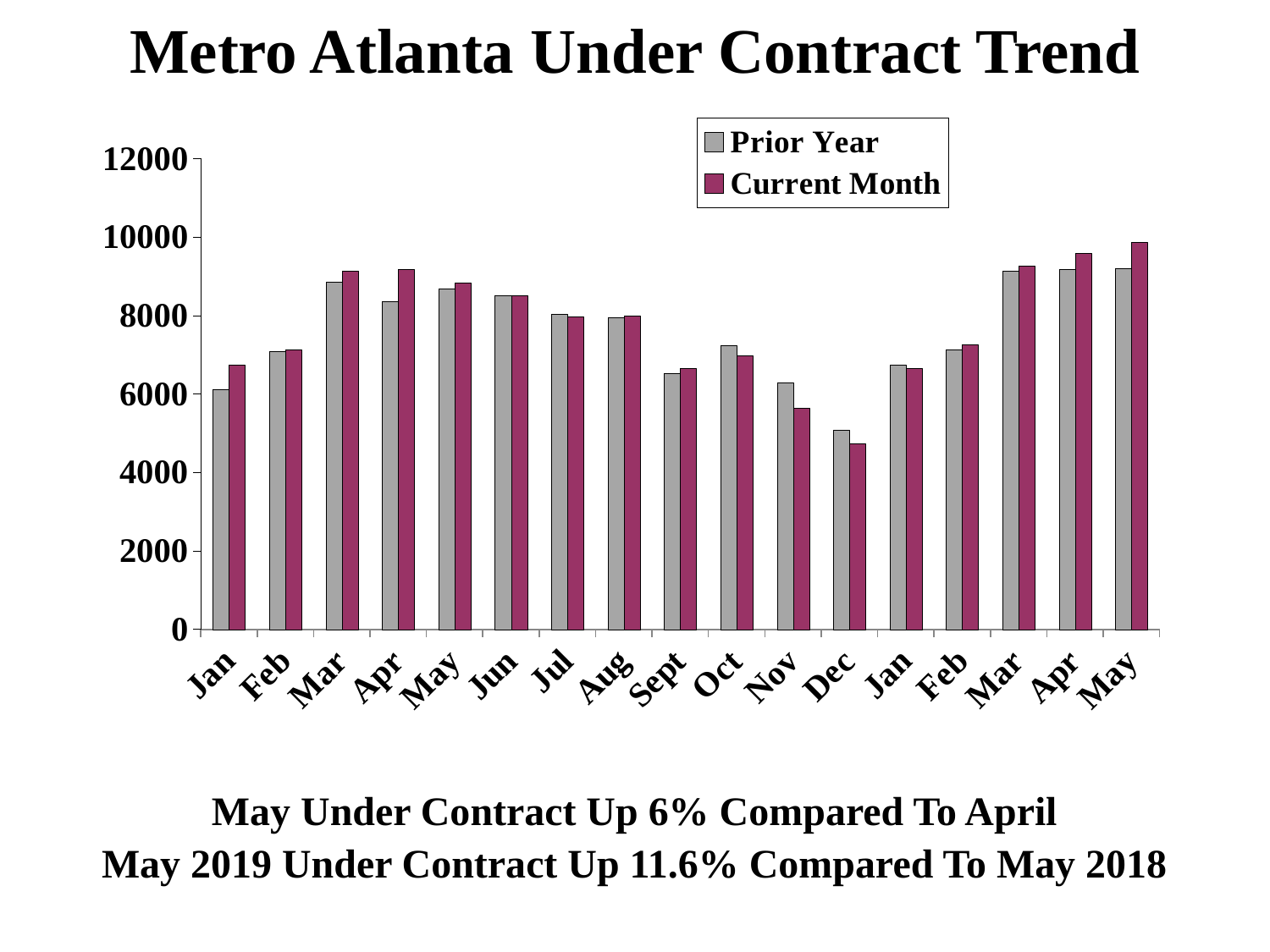
What kind of chart is shown on the slide? Bar chart How many series does the legend list? 2 How many month categories are shown along the x axis? 17 Which month has the highest Current Month value? May (the last month on the axis) For Nov, which series has the larger value, Prior Year or Current Month? Prior Year What colour are the Prior Year bars? Grey Is the Current Month value for the final May greater or less than 8000? greater Is the Current Month value for Nov greater or less than 6000? less Is the Current Month value for Dec greater or less than 6000? less For the first Jan on the axis, which series has the larger value, Prior Year or Current Month? Current Month Which month has the lowest Current Month value? Dec